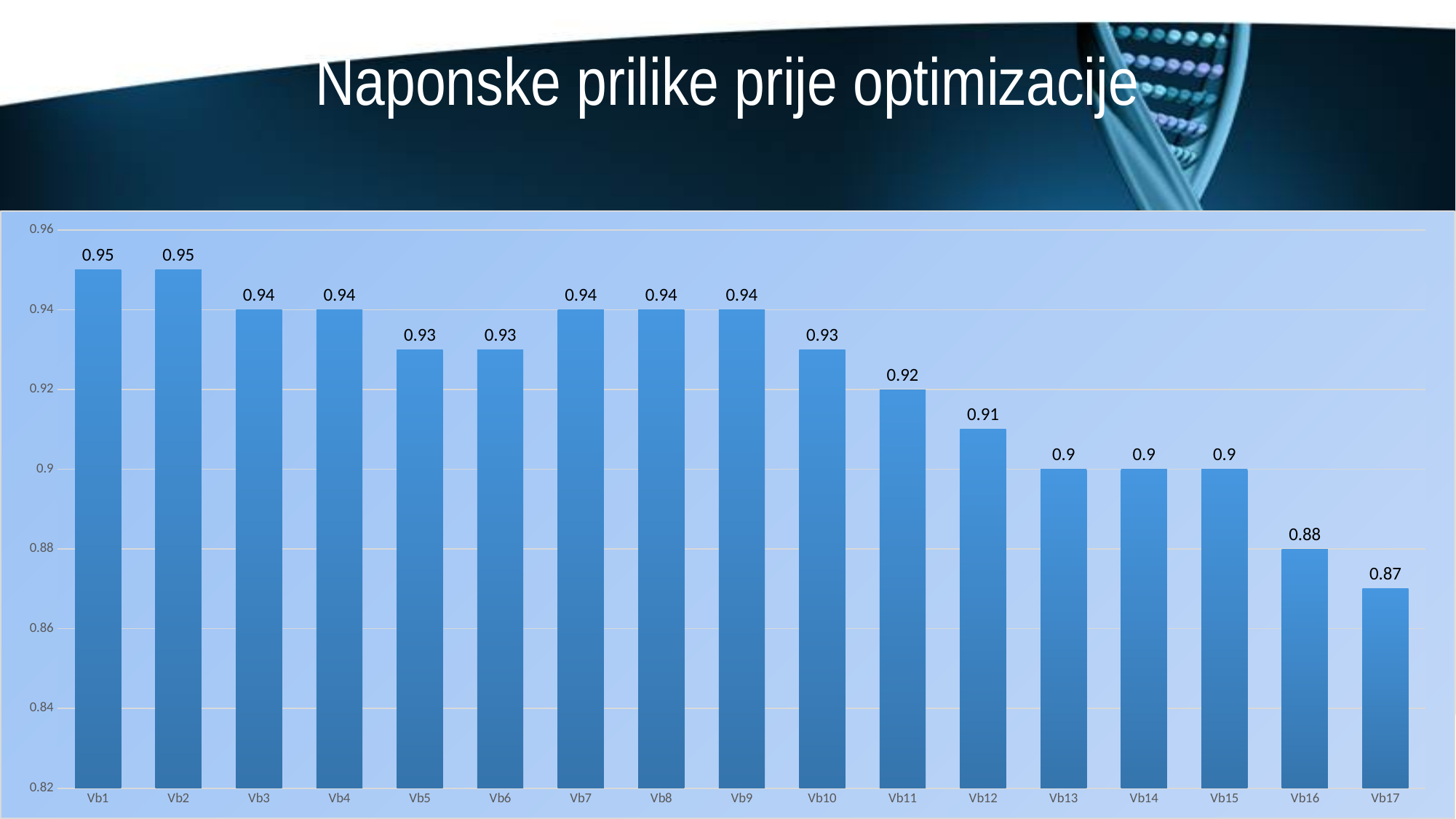
Which is larger, the value for Vb3 or the value for Vb12? Vb3 Which category has the lowest value? Vb17 What is the difference between the values for Vb1 and Vb17? 0.08 What is the title of the slide? Naponske prilike prije optimizacije What is the value for Vb10? 0.93 What is the difference between the values for Vb11 and Vb13? 0.02 How many categories are shown on the x axis? 17 Do the values generally rise or fall from Vb1 to Vb17? fall What kind of chart is shown on the slide? bar chart What is the value for Vb1? 0.95 What is the value for Vb16? 0.88 Is the value for Vb17 greater or less than 0.9? less